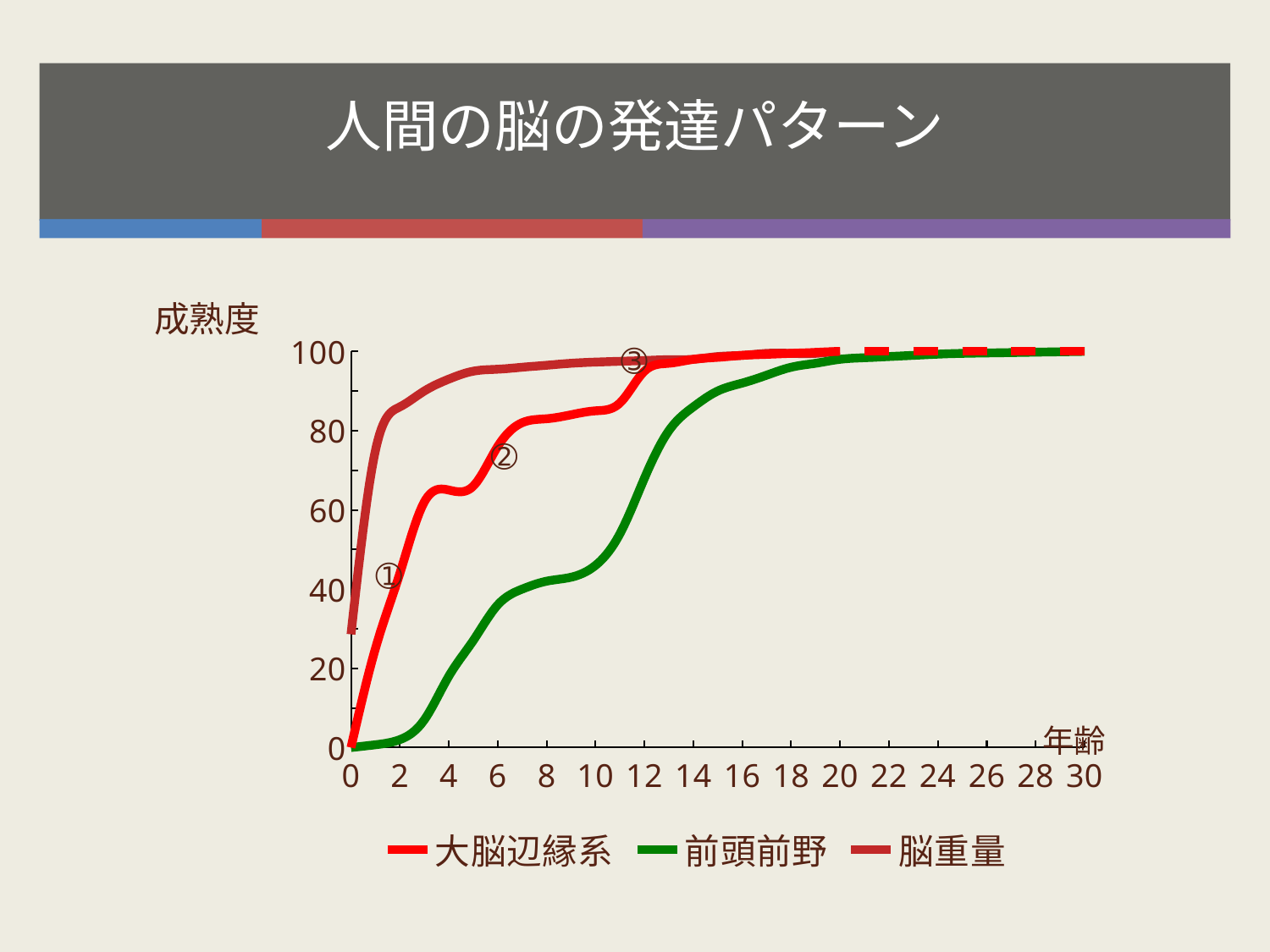
Is the value for 脳重量 at age 4 greater or less than 80? greater At age 10, which series has the higher value, 大脳辺縁系 or 前頭前野? 大脳辺縁系 Is the value for 大脳辺縁系 at age 6 greater or less than 60? greater Is the value for 大脳辺縁系 at age 12 greater or less than 80? greater How many series does the legend list? 3 At age 2, which series has the higher value, 脳重量 or 大脳辺縁系? 脳重量 What is the label on the vertical axis? 成熟度 What is the title of the chart? 人間の脳の発達パターン What kind of chart is shown on the slide? line chart Which series has the lowest value at age 6? 前頭前野